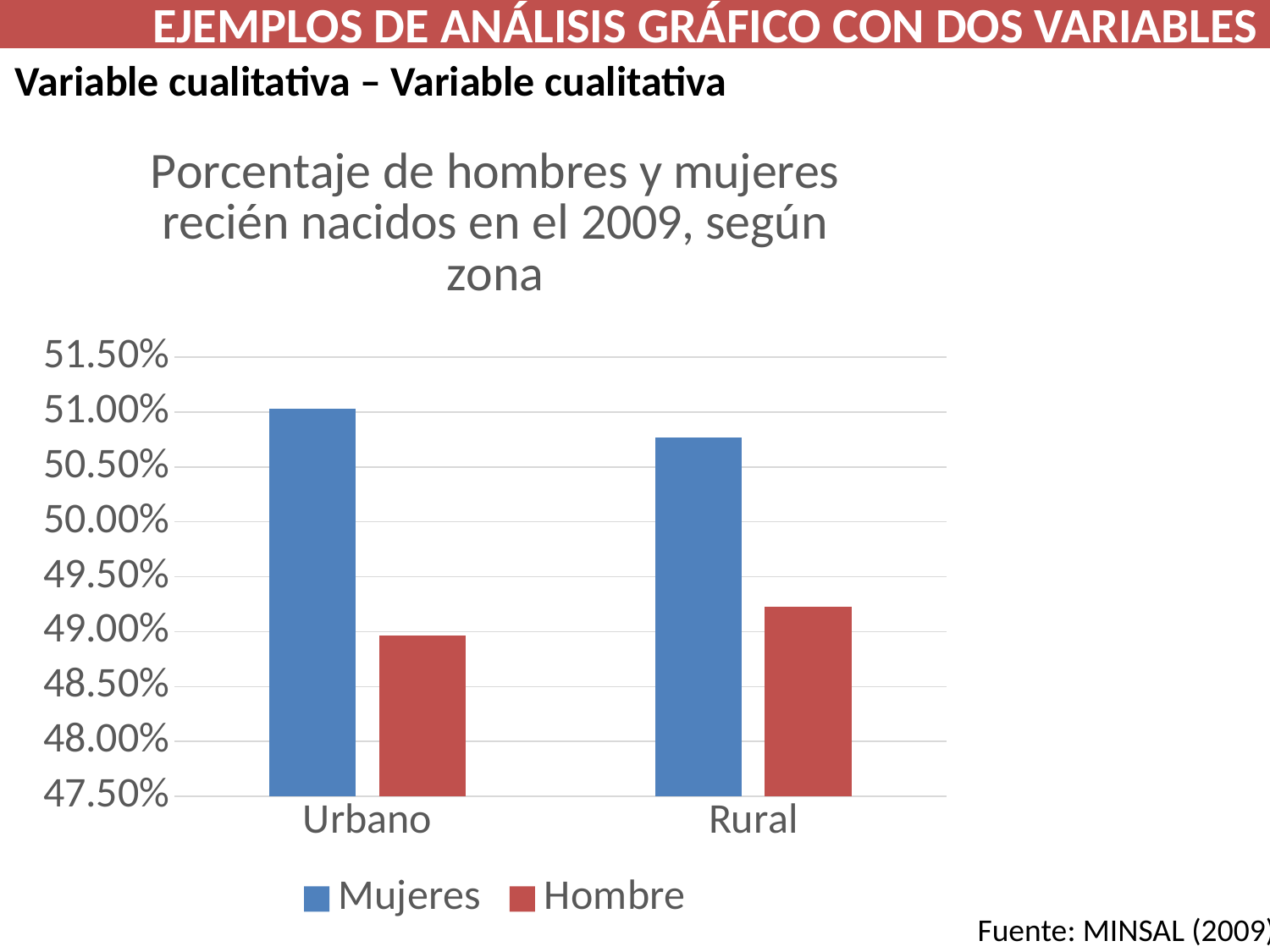
How many zone categories are shown on the x axis? 2 Is the value for Hombre in Urbano greater or less than 49.50%? less Which zone has the higher value for Hombre, Urbano or Rural? Rural Is the value for Hombre in Rural greater or less than 49.50%? less What kind of chart is shown on the slide? bar chart Is the value for Mujeres in Urbano greater or less than 50.50%? greater Which zone has the higher value for Mujeres, Urbano or Rural? Urbano Which bar is the tallest in the chart? Mujeres in Urbano How many series does the legend list? 2 Which series is shown in blue? Mujeres What is the title of the chart? Porcentaje de hombres y mujeres recién nacidos en el 2009, según zona